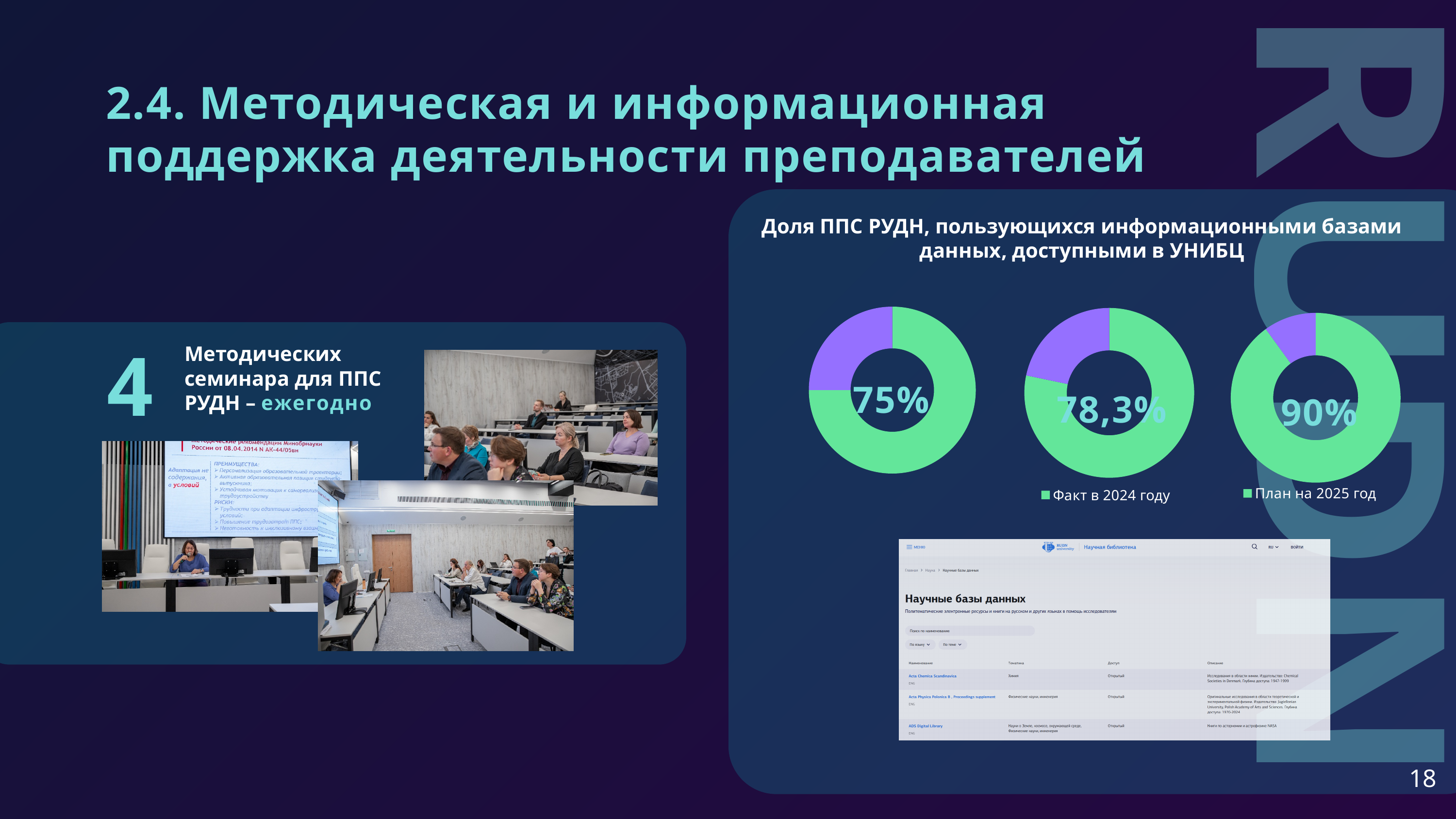
What value is shown in the centre of the left donut chart? 75% What kind of chart is used to show the share of RUDN teaching staff using the information databases? Pie (donut) chart Do the percentages in the donut charts rise or fall from left to right? Rise What value is shown in the centre of the right donut chart? 90% What is the difference between the value in the right donut chart and the value in the middle donut chart? 11,7% Which of the three donut charts shows the lowest percentage? The left one (75%) What is the difference between the value in the right donut chart and the value in the left donut chart? 15% Which is larger: the value in the middle donut chart or the value in the left donut chart? The middle one (78,3%) What are the two legend entries shown below the donut charts? Факт в 2024 году; План на 2025 год Which of the three donut charts shows the highest percentage? The right one (90%) What value is shown in the centre of the middle donut chart? 78,3% How many donut charts are shown on the slide? 3